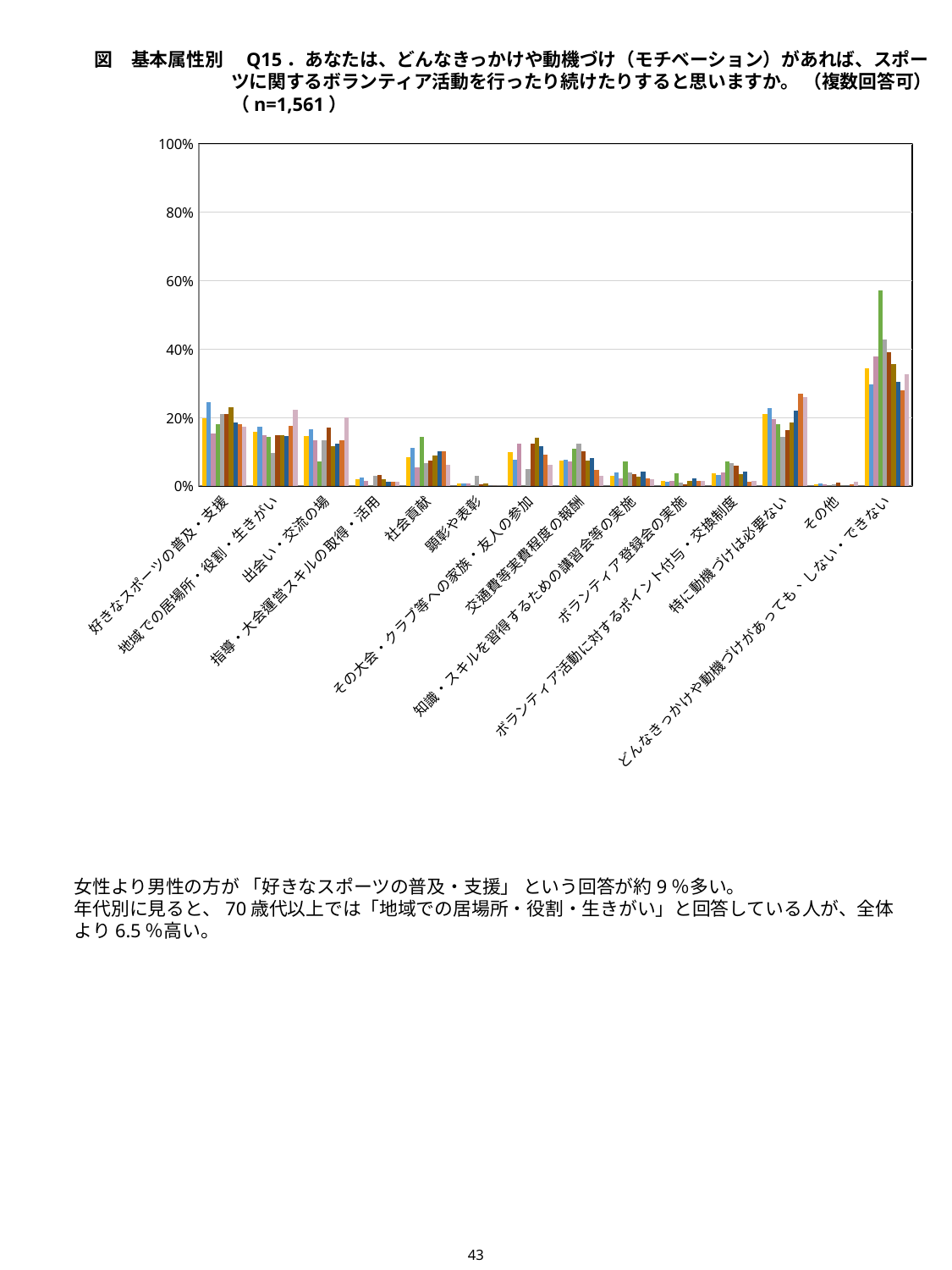
Which category contains the tallest bar in the chart? どんなきっかけや動機づけがあっても、しない・できない How many categories are shown along the x axis of the chart? 14 What kind of chart is shown on the slide? bar chart Is the tallest bar for どんなきっかけや動機づけがあっても、しない・できない greater or less than 40%? greater What sample size (n) is stated in the chart title? n=1,561 Is the tallest bar for 顕彰や表彰 greater or less than 20%? less Which category has the lowest bars overall in the chart? その他 Is the tallest bar for 好きなスポーツの普及・支援 greater or less than 40%? less Are the bars for 社会貢献 taller or shorter than the bars for 出会い・交流の場 overall? shorter What is the highest value shown on the y axis of the chart? 100%